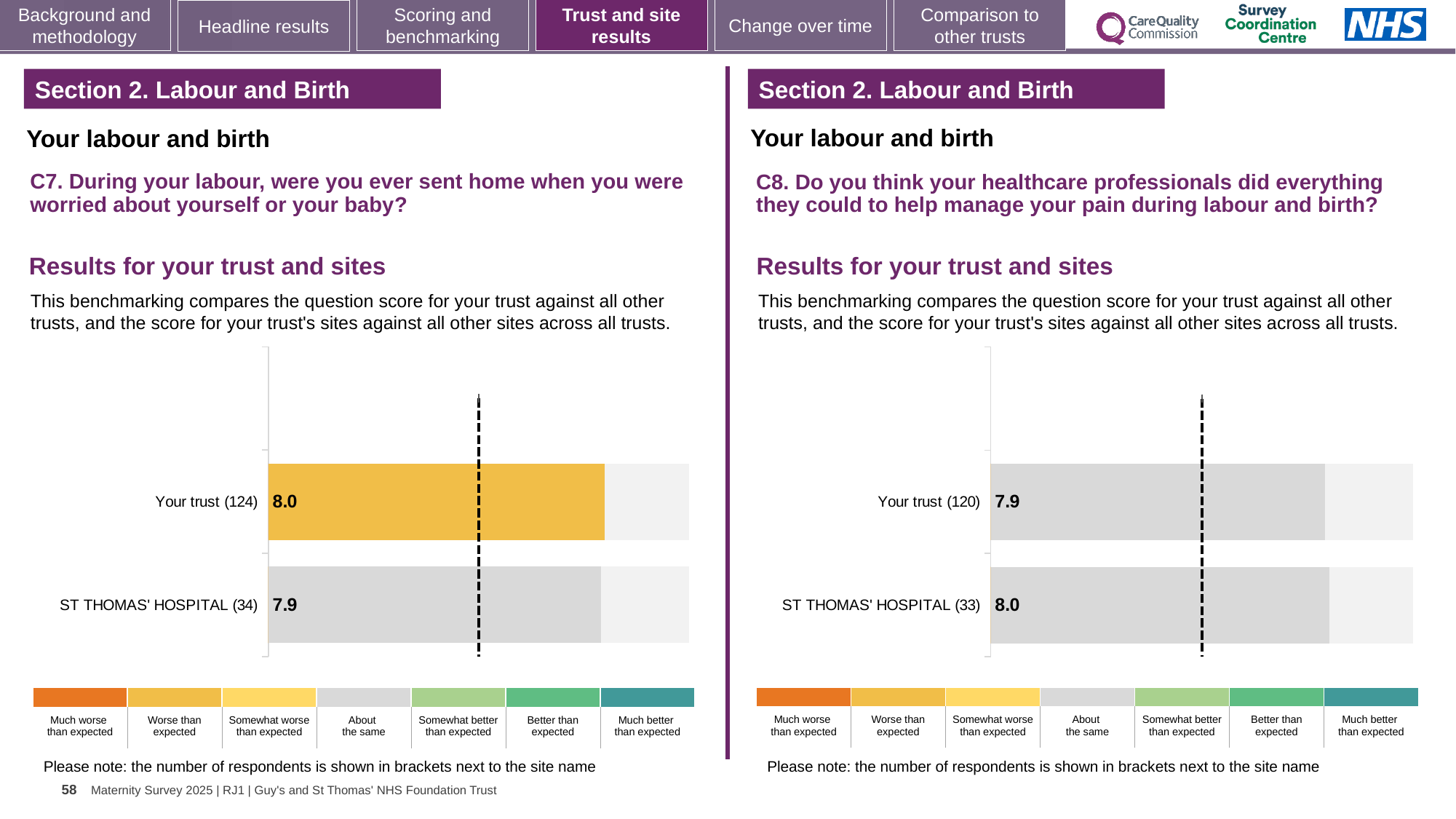
On the C8 chart (right), how many respondents are shown in brackets for ST THOMAS' HOSPITAL? 33 On the C7 chart (left), which has the higher score, Your trust or ST THOMAS' HOSPITAL? Your trust On the C8 chart (right), what is the score for Your trust? 7.9 How many bars are plotted on the C7 chart (left)? 2 What type of chart is used on the C8 chart (right)? Bar chart On the C8 chart (right), what is the difference between the ST THOMAS' HOSPITAL score and the Your trust score? 0.1 On the C7 chart (left), what is the score for ST THOMAS' HOSPITAL? 7.9 On the C8 chart (right), what is the score for ST THOMAS' HOSPITAL? 8.0 On the C7 chart (left), what is the difference between the Your trust score and the ST THOMAS' HOSPITAL score? 0.1 On the C7 chart (left), what is the score for Your trust? 8.0 On the C7 chart (left), how many respondents are shown in brackets for Your trust? 124 On the C8 chart (right), which has the higher score, Your trust or ST THOMAS' HOSPITAL? ST THOMAS' HOSPITAL